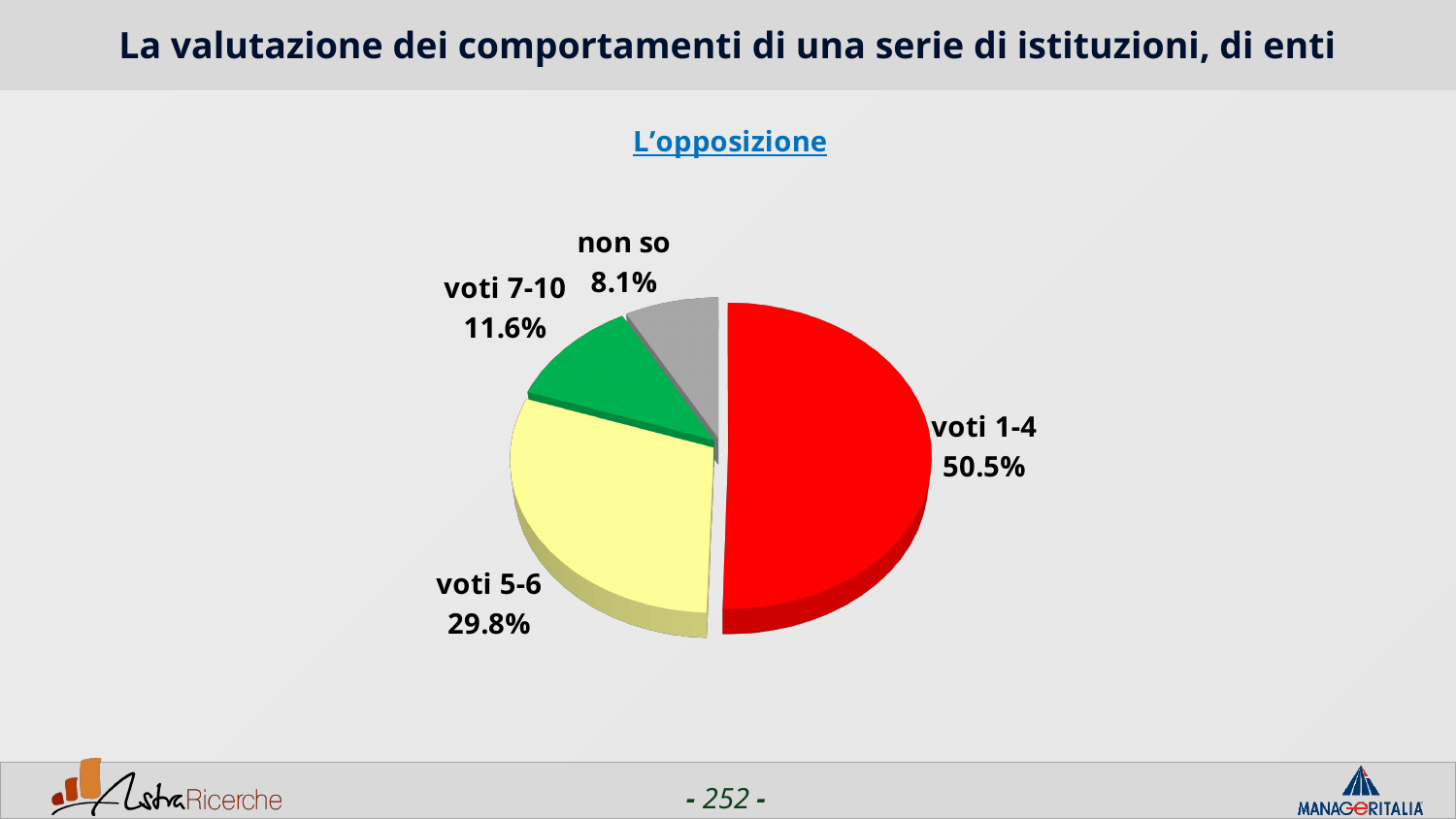
What kind of chart is shown on the slide? Pie chart What percentage of the pie is labelled "voti 5-6"? 29.8% What percentage of the pie is labelled "voti 1-4"? 50.5% What colour is the "voti 1-4" slice? Red Which is larger, the "voti 7-10" slice or the "non so" slice? voti 7-10 What percentage of the pie is labelled "voti 7-10"? 11.6% How many slices does the pie chart have? 4 What percentage of the pie is labelled "non so"? 8.1% What is the subtitle above the pie chart? L'opposizione Which slice of the pie is the smallest? non so Which slice of the pie is the largest? voti 1-4 What is the difference in percentage points between "voti 1-4" and "voti 5-6"? 20.7